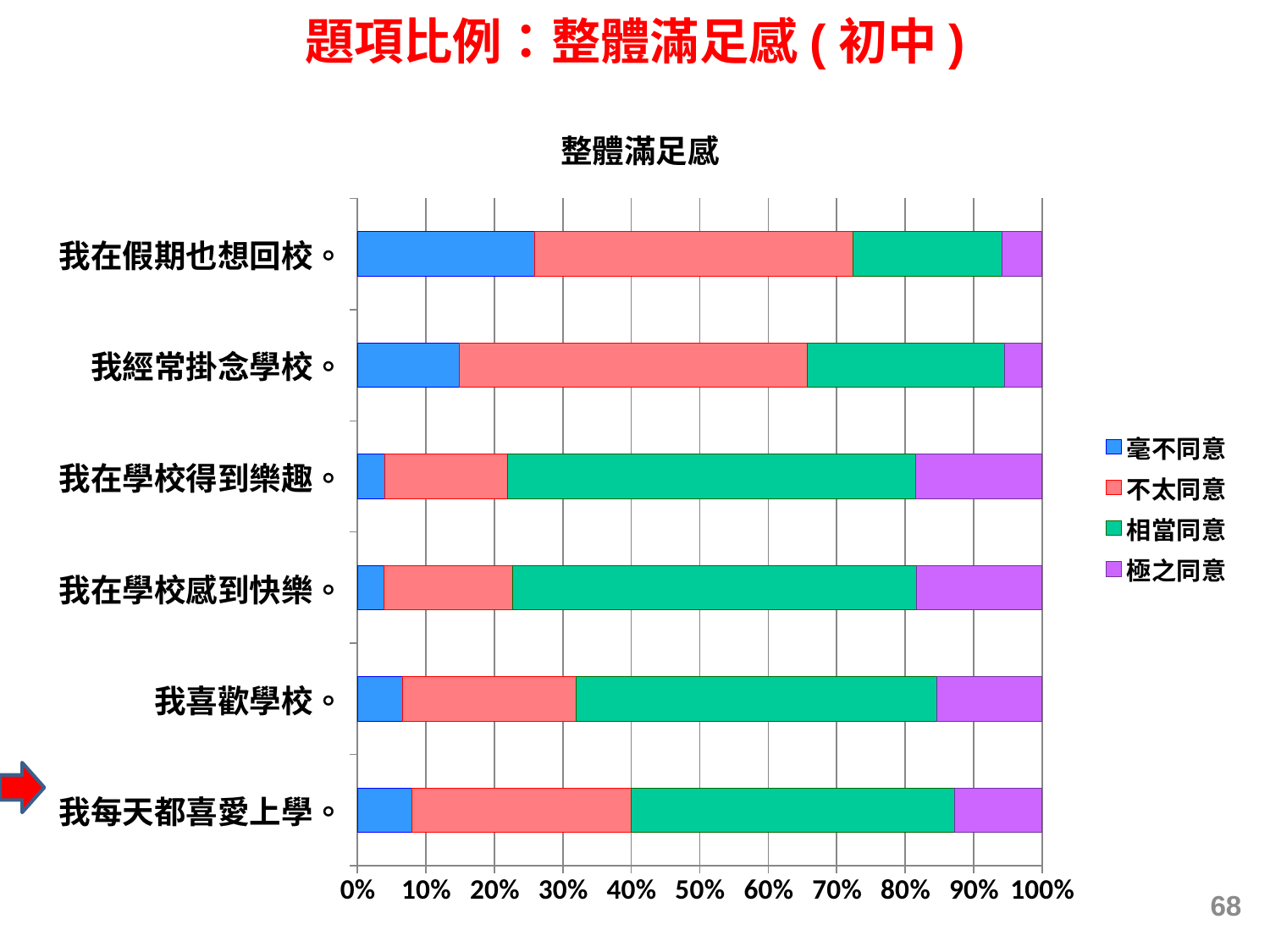
Is the 毫不同意 share for 我在假期也想回校。 greater or less than 20%? greater What is the title of the chart? 整體滿足感 Is the 相當同意 share for 我在學校得到樂趣。 greater or less than 50%? greater Is the 毫不同意 share for 我經常掛念學校。 greater or less than 10%? greater Which statement has the largest 毫不同意 segment? 我在假期也想回校。 How many statements (categories) are plotted in the chart? 6 Which statement has the smallest 相當同意 segment? 我在假期也想回校。 Which legend entry is shown in green? 相當同意 What kind of chart is shown on the slide? bar chart How many series does the legend list? 4 Which has the larger 極之同意 segment: 我在學校得到樂趣。 or 我在假期也想回校。? 我在學校得到樂趣。